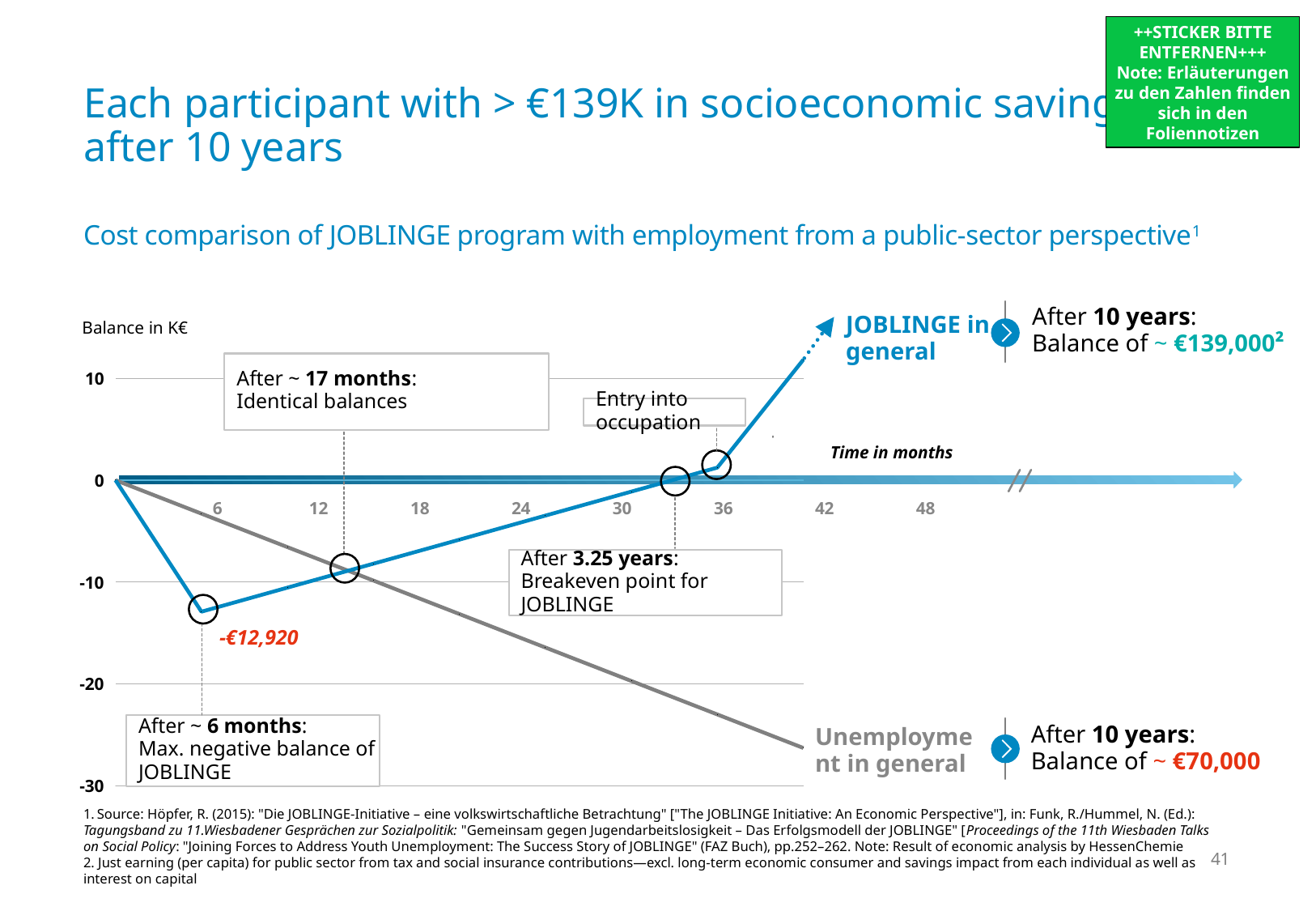
Is the JOBLINGE balance at 6 months greater or less than -10? less What is the label of the vertical axis of the chart? Balance in K€ What kind of chart is shown on the slide? line chart After 10 years, which series has the higher balance, JOBLINGE in general or Unemployment in general? JOBLINGE in general Does the Unemployment in general line rise or fall as time in months increases? falls Is the Unemployment in general balance at 48 months greater or less than -20? less What is the maximum negative balance of JOBLINGE shown on the chart? -€12,920 After how long does the chart say the breakeven point for JOBLINGE is reached? 3.25 years How many series (lines) are plotted on the chart? 2 After how many months does the chart say the two balances are identical? ~ 17 months At 30 months, which series has the higher balance, JOBLINGE in general or Unemployment in general? JOBLINGE in general